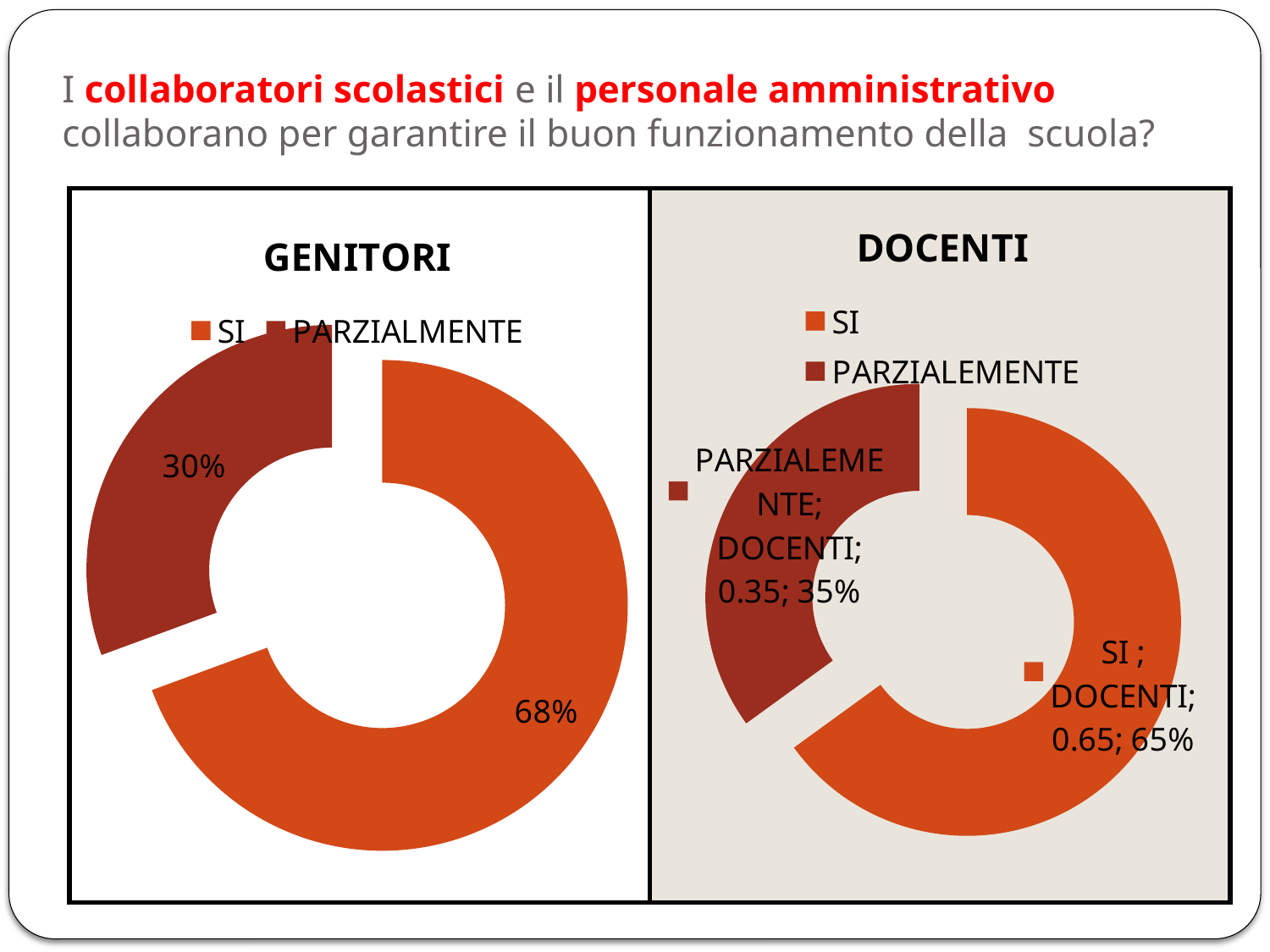
In the DOCENTI chart, what percentage is shown for PARZIALEMENTE? 35% In the DOCENTI chart, which category has the smallest share? PARZIALEMENTE In the GENITORI chart, what percentage is shown for PARZIALMENTE? 30% What kind of chart is the GENITORI chart? Doughnut chart In the GENITORI chart, which category has the largest share? SI In the GENITORI chart, what percentage is shown for SI? 68% In the GENITORI chart, what is the difference in percentage points between SI and PARZIALMENTE? 38 percentage points In the DOCENTI chart, what percentage is shown for SI? 65% In the DOCENTI chart, what is the difference in percentage points between SI and PARZIALEMENTE? 30 percentage points Which is larger: the SI share in the GENITORI chart or the SI share in the DOCENTI chart? GENITORI How many series does the legend of the DOCENTI chart list? 2 What is the title of the chart on the right side of the slide? DOCENTI